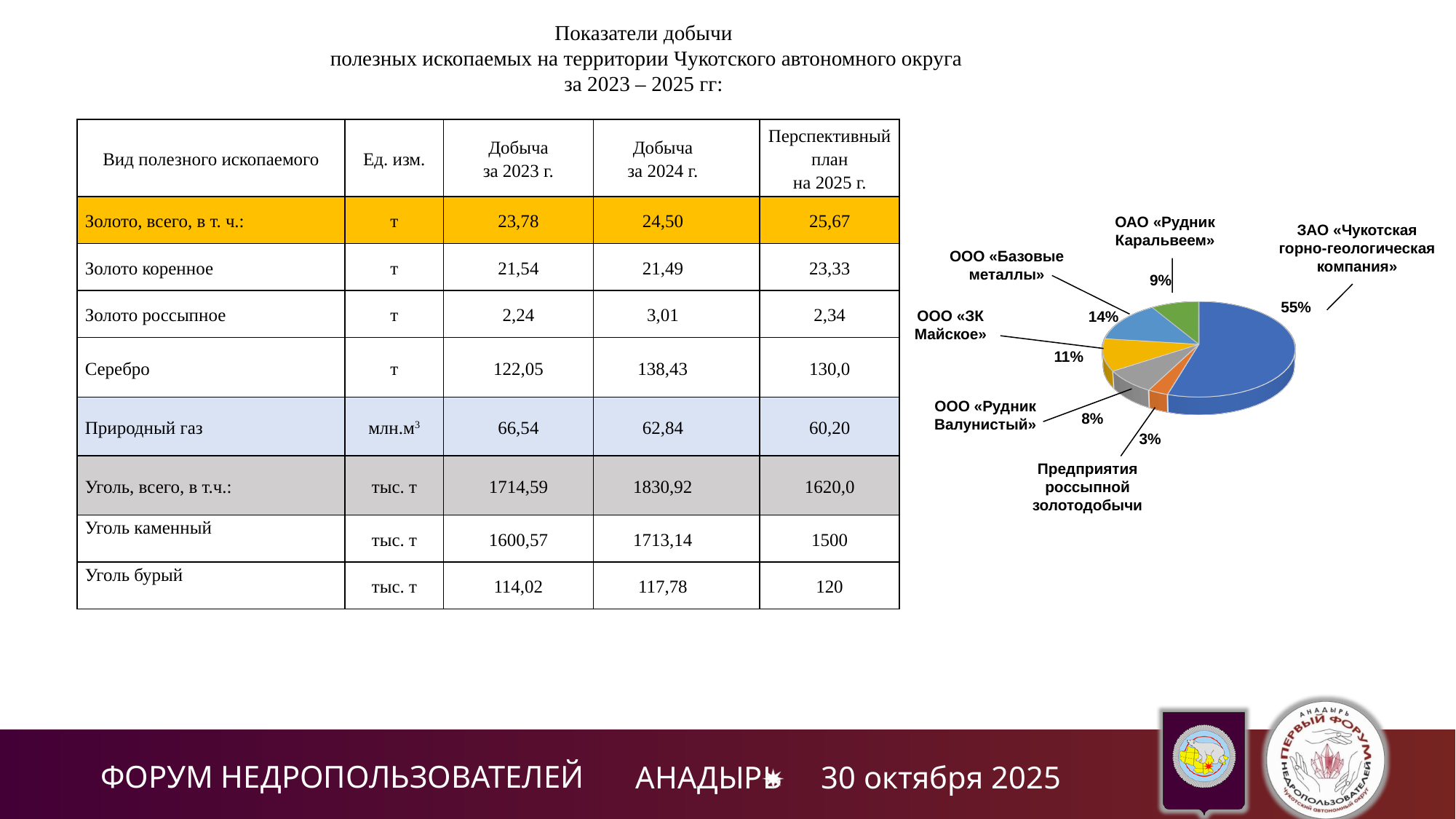
Which slice of the pie chart is the smallest? Предприятия россыпной золотодобычи In the pie chart, which has the larger share: ОАО «Рудник Каральвеем» or ООО «Рудник Валунистый»? ОАО «Рудник Каральвеем» In the pie chart, what share is shown for ОАО «Рудник Каральвеем»? 9% In the pie chart, what share is shown for ЗАО «Чукотская горно-геологическая компания»? 55% What kind of chart is shown on the right side of the slide? pie chart How many slices does the pie chart have? 6 In the pie chart, what share is shown for ООО «Базовые металлы»? 14% In the pie chart, what is the difference in percentage points between ООО «Базовые металлы» and ООО «ЗК Майское»? 3 In the pie chart, what share is shown for ООО «ЗК Майское»? 11% Which slice of the pie chart is the largest? ЗАО «Чукотская горно-геологическая компания» In the pie chart, what share is shown for ООО «Рудник Валунистый»? 8% In the pie chart, what share is shown for Предприятия россыпной золотодобычи? 3%